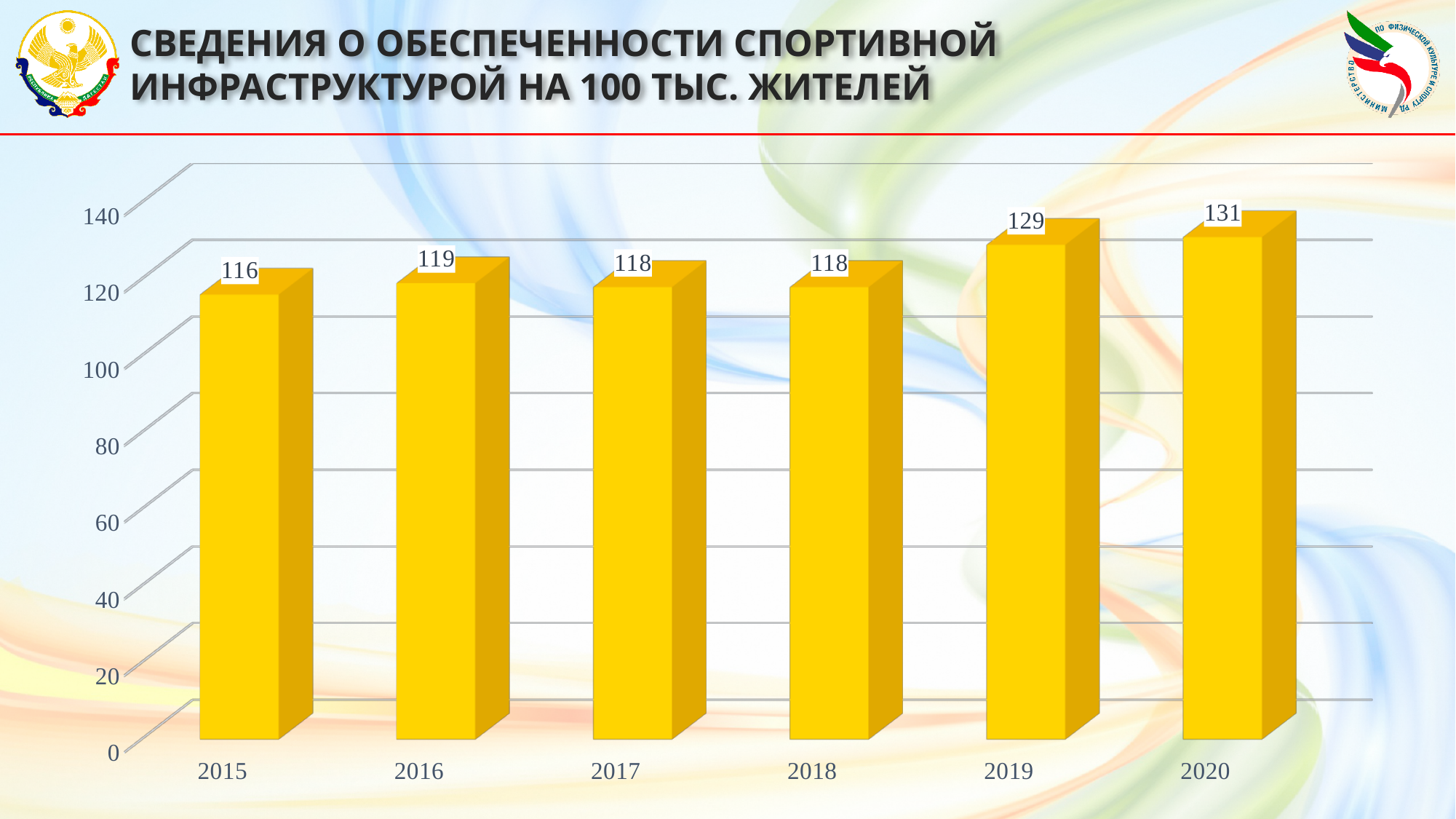
How many years are shown on the x axis? 6 What is the value for 2019? 129 Which year has the highest value? 2020 What is the value for 2015? 116 What kind of chart is shown on the slide? bar chart Which is larger, the value for 2016 or the value for 2017? 2016 Which year has the lowest value? 2015 What is the value for 2020? 131 Do the values generally rise or fall from 2015 to 2020? rise Is the value for 2019 greater or less than 120? greater What is the difference between the values for 2020 and 2015? 15 What is the difference between the values for 2019 and 2018? 11